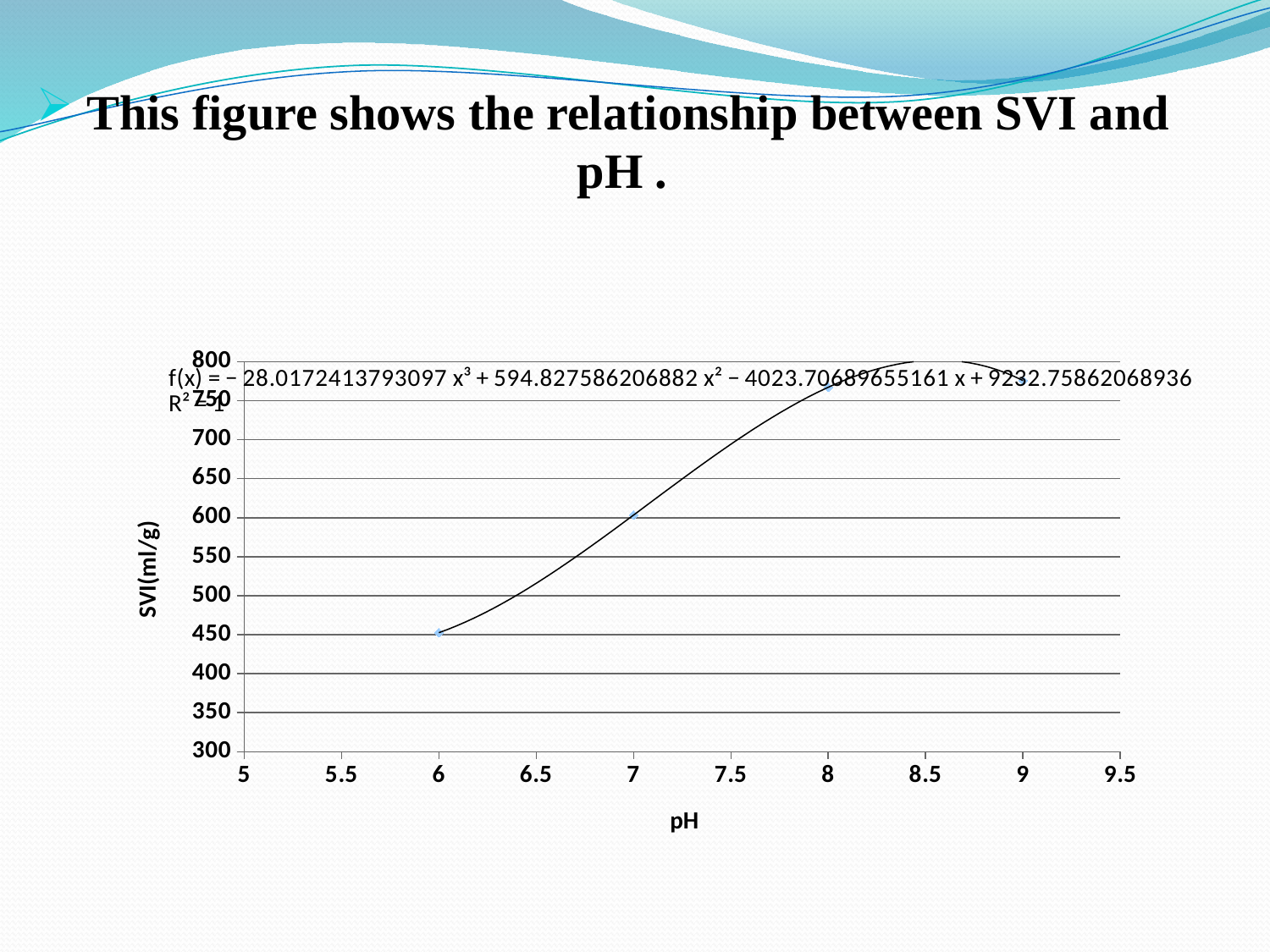
Is the SVI value at pH 8 greater or less than 700? greater At which pH is the SVI value lowest? 6 What kind of chart is shown on the slide? scatter chart Is the SVI value at pH 9 greater or less than 700? greater Is the SVI value at pH 7 greater or less than 550? greater Which has a higher SVI value, pH 6 or pH 7? pH 7 How many data points are plotted on the chart? 4 What R² value is shown for the trendline? 1 What is the label of the y axis? SVI(ml/g) What is the label of the x axis? pH Does the SVI value rise or fall as pH increases from 6 to 8? rise